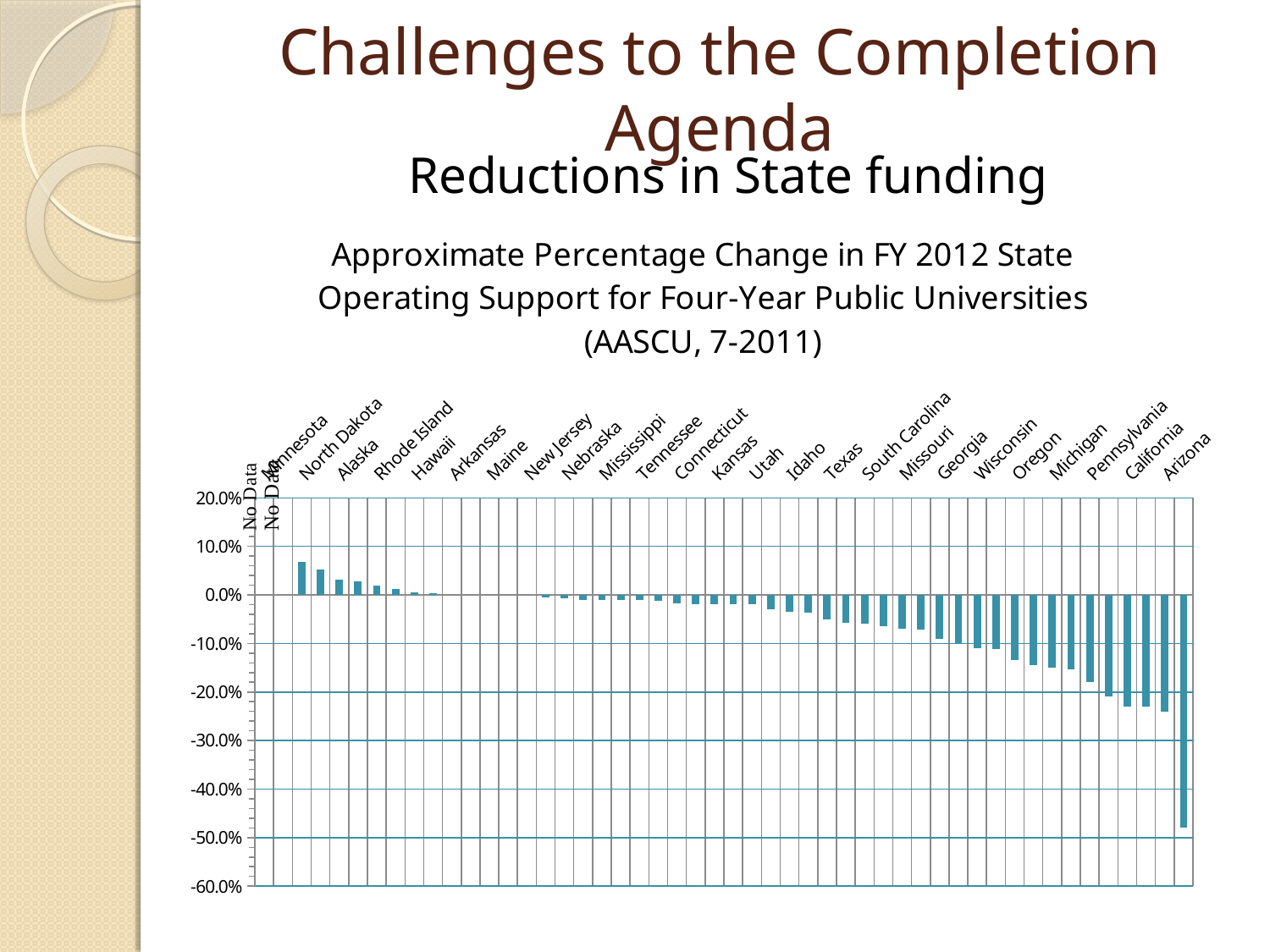
What kind of chart is shown on the slide? bar chart What is the lowest value shown on the vertical axis? -60.0% Do the values generally rise or fall moving from left to right along the x axis? fall Is the value for Texas greater or less than -10.0%? greater Is the value for California greater or less than -20.0%? less Which has the larger value, Arizona or California? California Is the value for Arizona greater or less than -40.0%? greater What is the title of the chart? Approximate Percentage Change in FY 2012 State Operating Support for Four-Year Public Universities (AASCU, 7-2011)